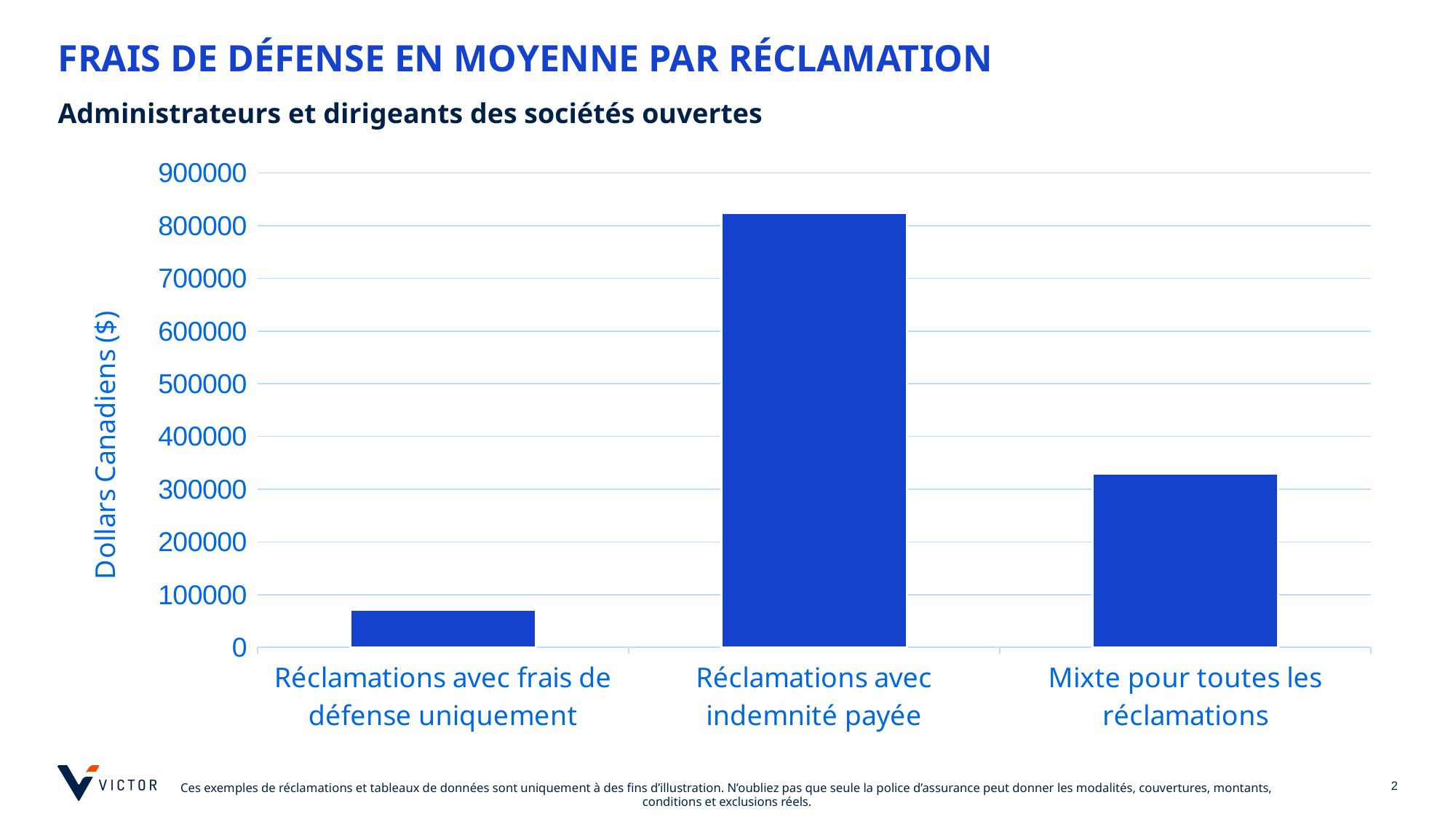
Which is larger: the value for Mixte pour toutes les réclamations or the value for Réclamations avec frais de défense uniquement? Mixte pour toutes les réclamations Which category has the highest average defence cost? Réclamations avec indemnité payée Is the value for Réclamations avec frais de défense uniquement greater or less than 100000? less Which is larger: the value for Réclamations avec indemnité payée or the value for Mixte pour toutes les réclamations? Réclamations avec indemnité payée Is the value for Réclamations avec indemnité payée greater or less than 800000? greater Which category has the lowest average defence cost? Réclamations avec frais de défense uniquement Is the value for Mixte pour toutes les réclamations greater or less than 400000? less What is the title of the slide containing the chart? FRAIS DE DÉFENSE EN MOYENNE PAR RÉCLAMATION What kind of chart is shown on the slide? bar chart What is the label of the vertical axis? Dollars Canadiens ($) How many categories are plotted on the chart? 3